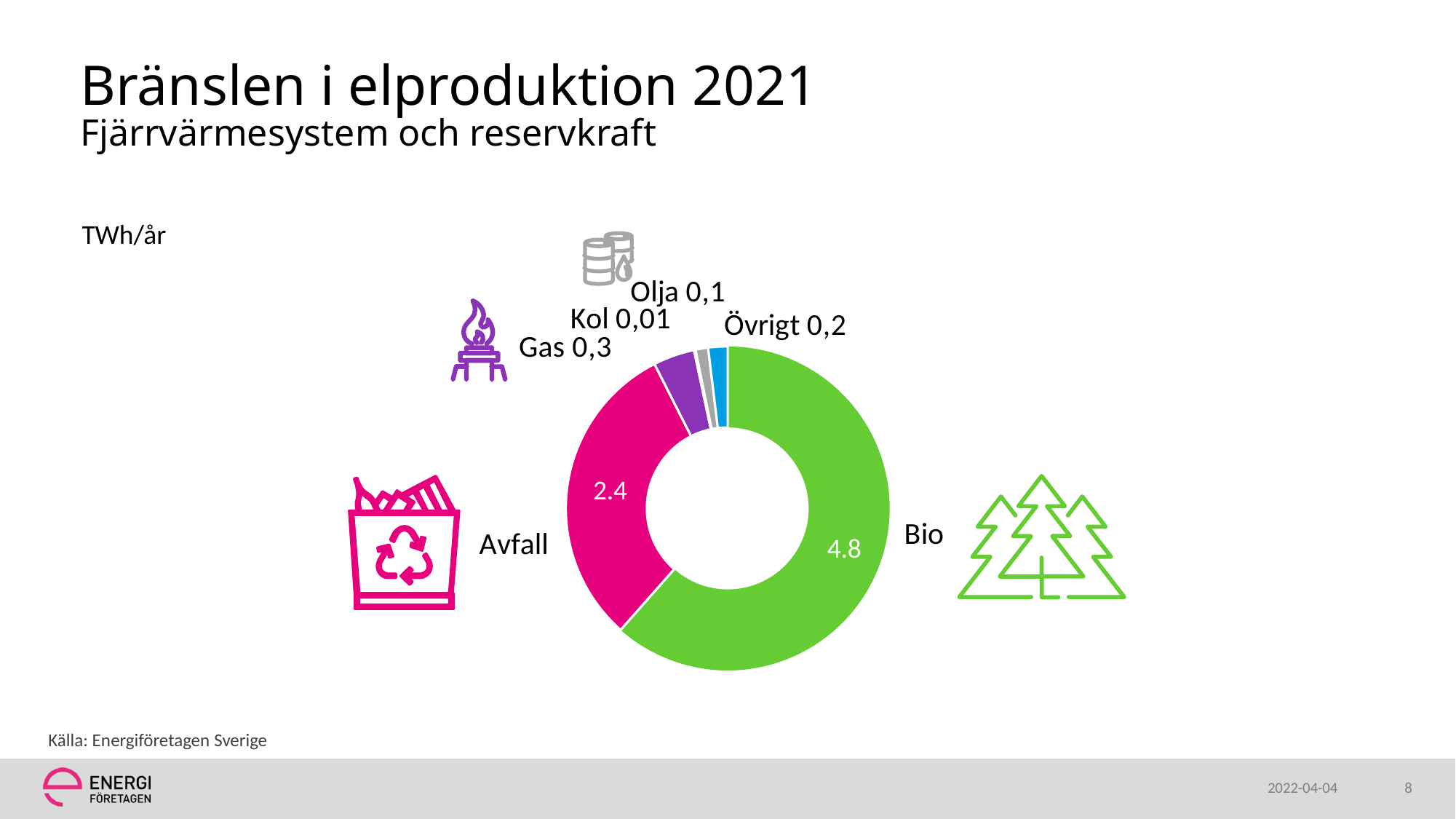
What is the value for Avfall? 2.4 What is the value for Bio? 4.8 What type of chart is shown on the slide? Pie (donut) chart What is the difference between the values for Bio and Avfall? 2.4 Which is larger, the value for Olja or the value for Övrigt? Övrigt What is the value for Kol? 0,01 Which category has the largest slice? Bio How many categories are shown in the chart? 6 Which category has the smallest value? Kol What unit is stated for the values in the chart? TWh/år What is the value for Övrigt? 0,2 What is the value for Gas? 0,3